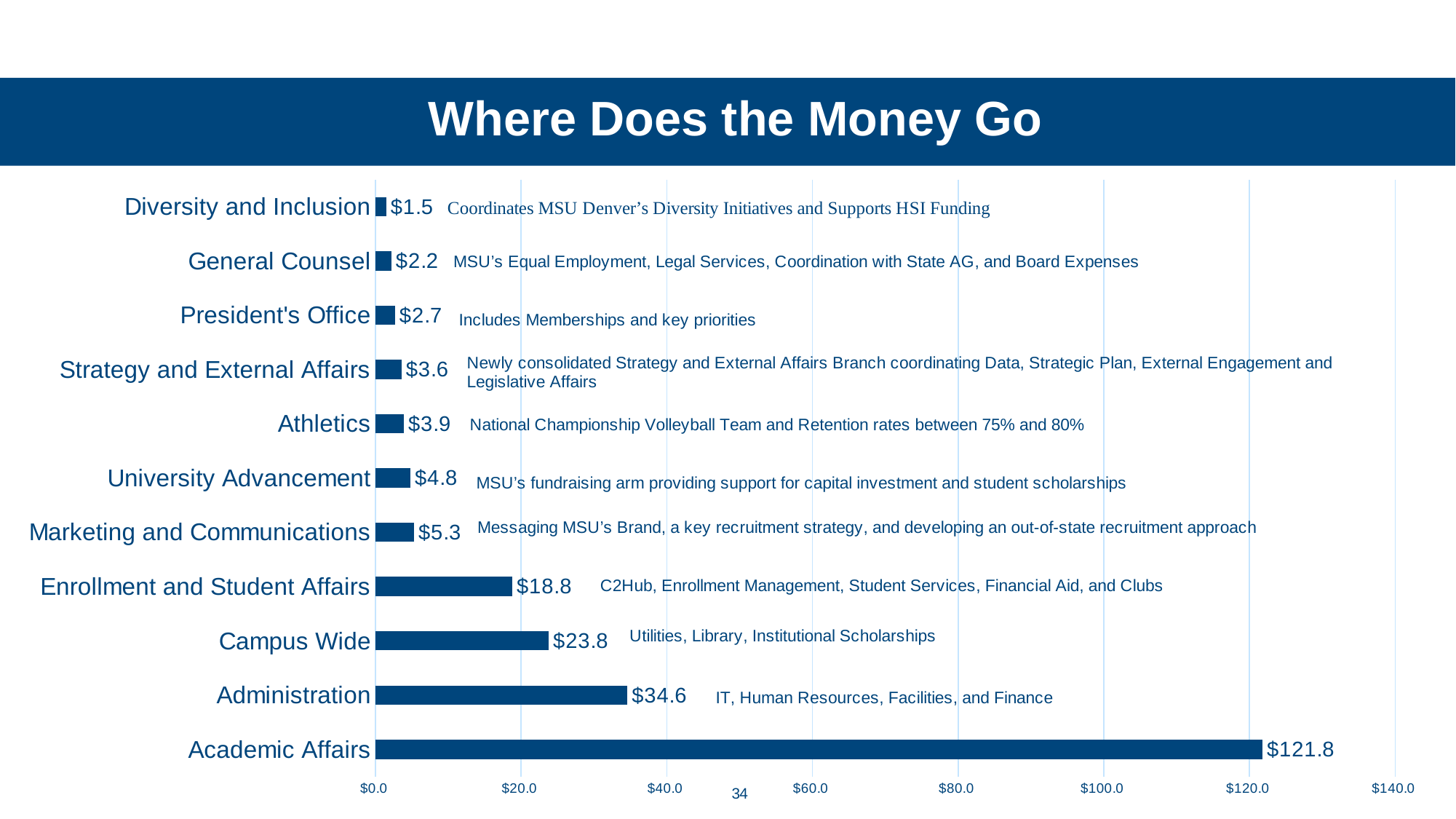
Which category has the lowest value? Diversity and Inclusion What is the value for Enrollment and Student Affairs? $18.8 Which is larger, the value for Marketing and Communications or the value for University Advancement? Marketing and Communications What is the difference between the values for Administration and Campus Wide? $10.8 Is the value for Academic Affairs greater or less than $100.0? greater How many categories are shown in the chart? 11 What kind of chart is shown on the slide? bar chart What is the title of the slide? Where Does the Money Go What is the value for Administration? $34.6 What is the value for Athletics? $3.9 What is the value for Academic Affairs? $121.8 Which category has the highest value? Academic Affairs